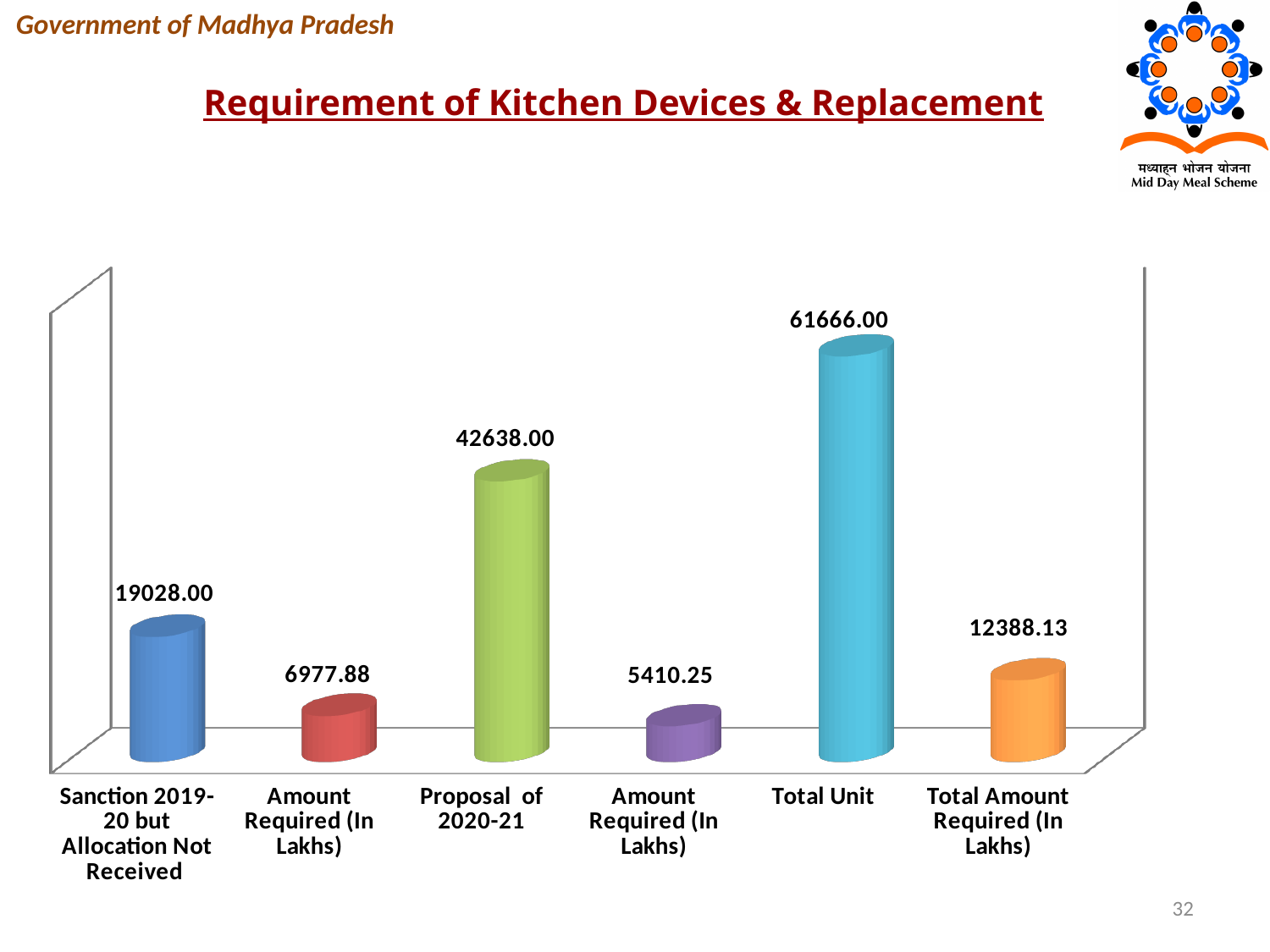
What is the value for Proposal of 2020-21? 42638.00 What is the difference between Total Unit and Proposal of 2020-21? 19028.00 What is the value for Total Amount Required (In Lakhs)? 12388.13 How many categories are shown in the chart? 6 What kind of chart is shown on the slide? Bar chart Which category has the lowest value? Amount Required (In Lakhs) (the fourth bar, 5410.25) What is the value for Sanction 2019-20 but Allocation Not Received? 19028.00 Which category has the highest value? Total Unit What is the value of the second bar from the left, labelled Amount Required (In Lakhs), next to Sanction 2019-20? 6977.88 Which is larger, Proposal of 2020-21 or Sanction 2019-20 but Allocation Not Received? Proposal of 2020-21 What is the value of the fourth bar from the left, labelled Amount Required (In Lakhs), next to Proposal of 2020-21? 5410.25 What is the value for Total Unit? 61666.00